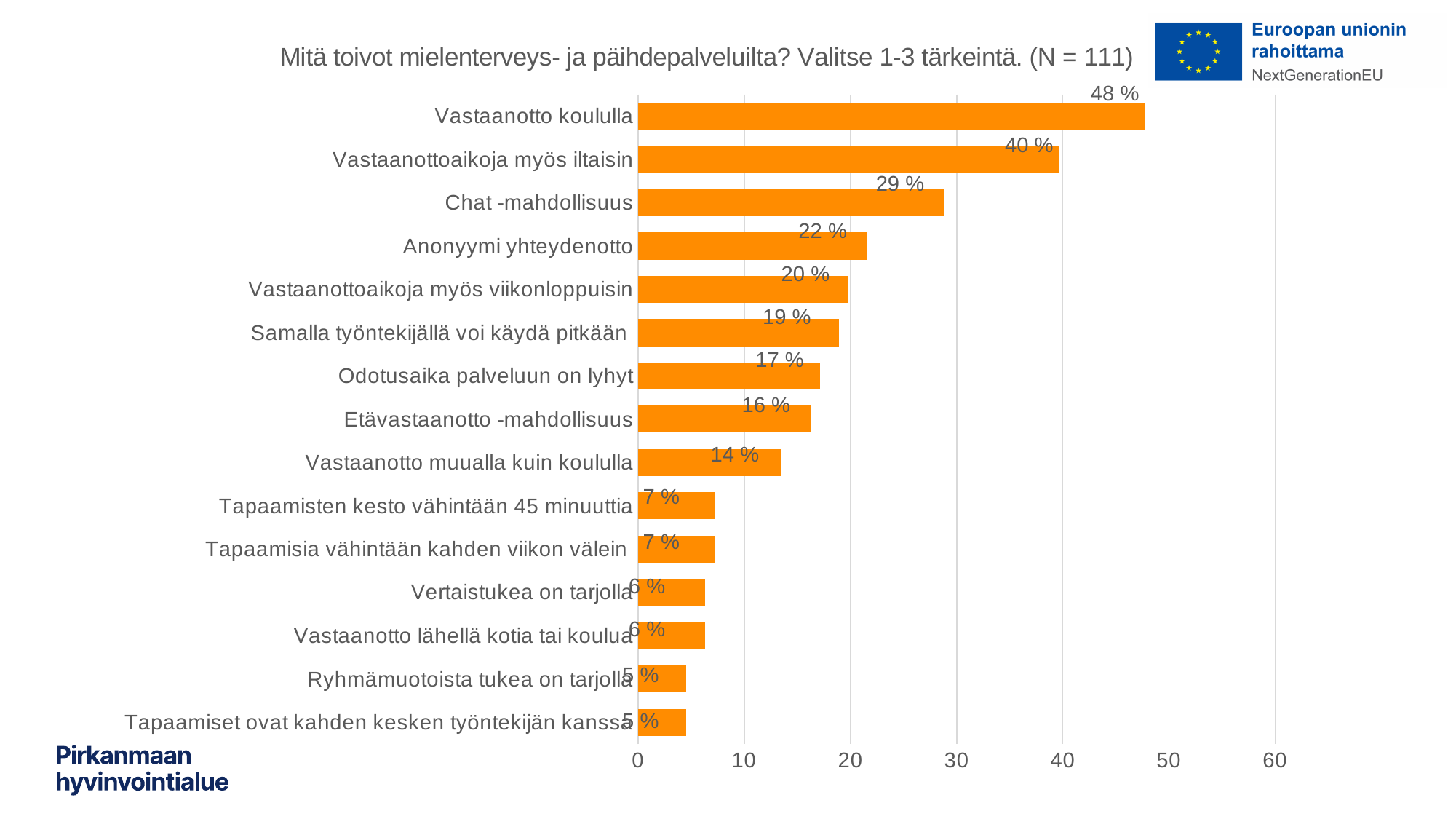
What is the value for Vastaanotto koululla? 48 % What is the lowest percentage shown in the chart? 5 % What is the value for Etävastaanotto -mahdollisuus? 16 % What is the difference between Vastaanotto koululla and Vastaanottoaikoja myös iltaisin? 8 % Is the value for Vastaanottoaikoja myös iltaisin greater or less than 30? greater Which category has the highest value? Vastaanotto koululla What is the value for Vastaanotto muualla kuin koululla? 14 % What type of chart is shown on the slide? bar chart What is the N value stated in the chart title? 111 What is the value for Chat -mahdollisuus? 29 % How many categories are shown in the chart? 15 Which is larger, Anonyymi yhteydenotto or Odotusaika palveluun on lyhyt? Anonyymi yhteydenotto